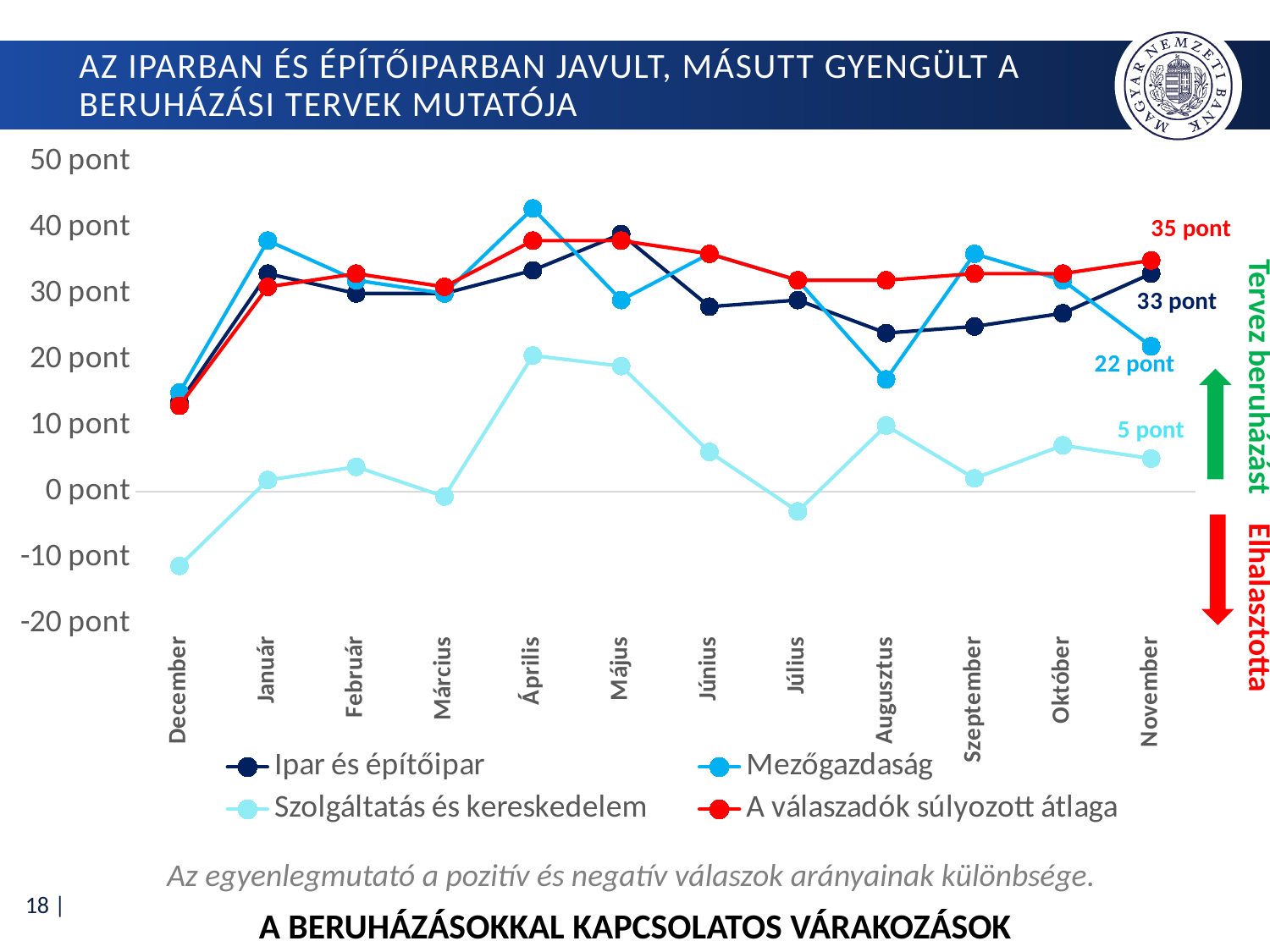
What type of chart is shown on the slide? line chart Is the value for 'Szolgáltatás és kereskedelem' in December greater or less than 0 pont? less Which series has the highest value in November? A válaszadók súlyozott átlaga What is the November value for 'Szolgáltatás és kereskedelem'? 5 pont How many months are shown on the x axis? 12 Is the value for 'Mezőgazdaság' in Április greater or less than 40 pont? greater Which series has the lowest value in November? Szolgáltatás és kereskedelem What is the November value for 'Mezőgazdaság'? 22 pont What is the November value for 'Ipar és építőipar'? 33 pont What is the November value for 'A válaszadók súlyozott átlaga'? 35 pont How many series does the legend list? 4 What is the difference between the November values of 'Ipar és építőipar' and 'Mezőgazdaság'? 11 pont